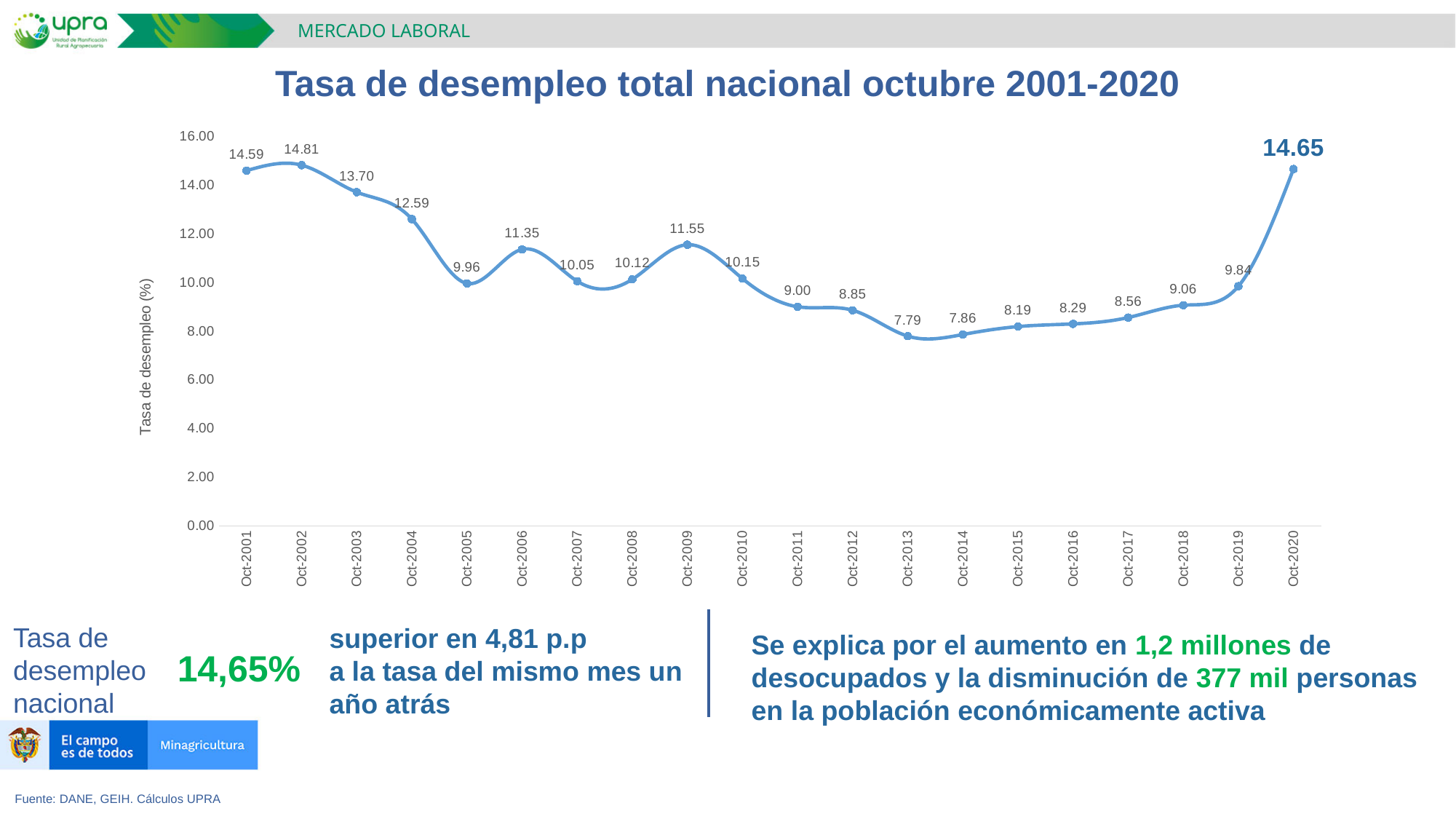
Which is larger, the value for Oct-2006 or the value for Oct-2007? Oct-2006 How many data points are plotted on the chart? 20 What is the unemployment rate shown for Oct-2009? 11.55 What is the difference between the values for Oct-2002 and Oct-2001? 0.22 Which year has the lowest unemployment rate on the chart? Oct-2013 What kind of chart is shown on the slide? Line chart What is the difference between the values for Oct-2020 and Oct-2019? 4.81 What is the unemployment rate shown for Oct-2020? 14.65 Do the values rise or fall from Oct-2013 to Oct-2020? Rise Which year has the highest unemployment rate on the chart? Oct-2002 What is the title of the chart? Tasa de desempleo total nacional octubre 2001-2020 What is the value plotted for Oct-2013? 7.79